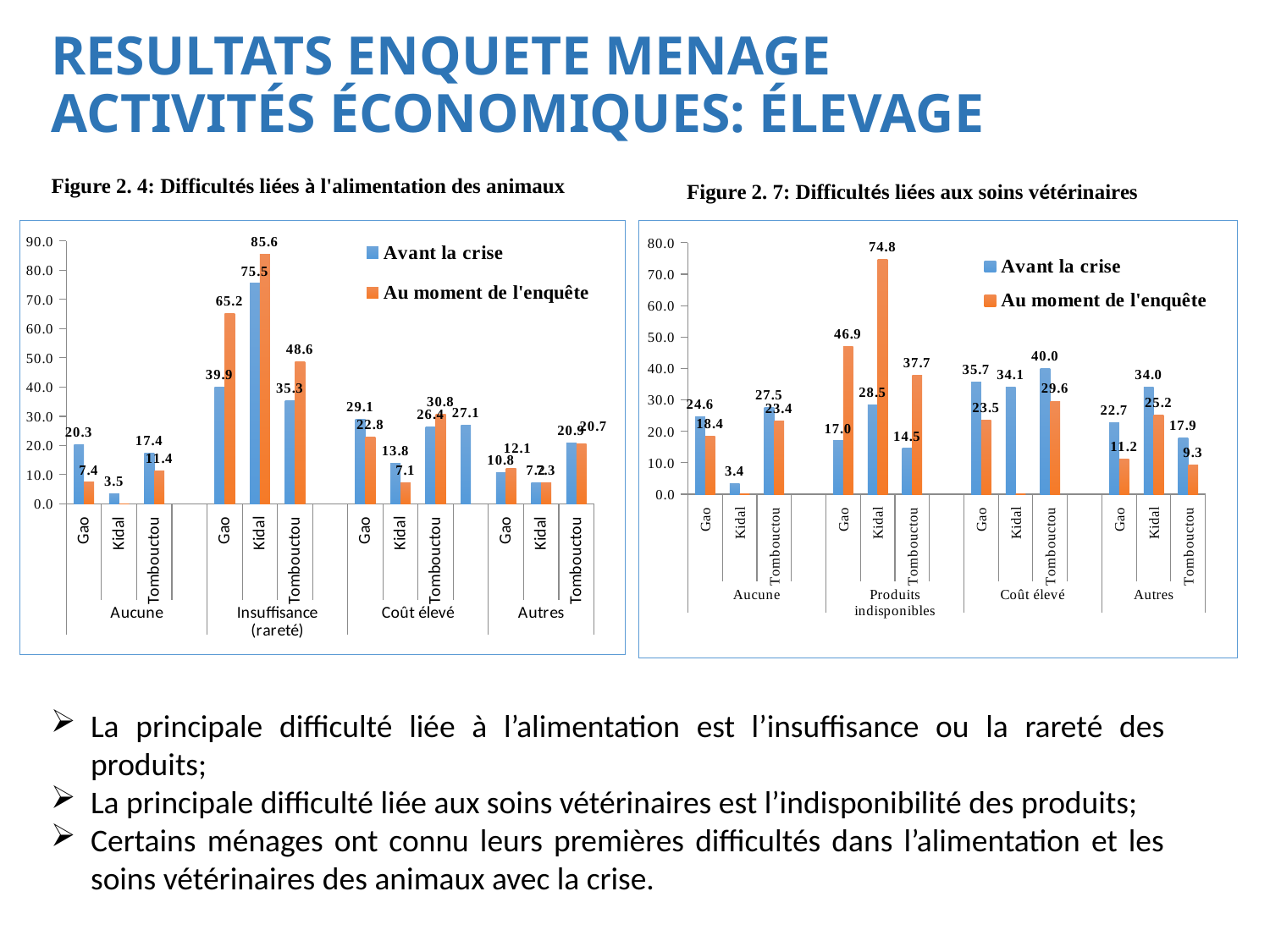
In Figure 2.4 (Difficultés liées à l'alimentation des animaux), what is the difference between the Au moment de l'enquête and Avant la crise values for Gao under Insuffisance (rareté)? 25.3 In Figure 2.4 (Difficultés liées à l'alimentation des animaux), for Kidal under Coût élevé, which series has the larger value: Avant la crise or Au moment de l'enquête? Avant la crise In Figure 2.7 (Difficultés liées aux soins vétérinaires), how many difficulty categories are shown on the x axis? 4 In Figure 2.4 (Difficultés liées à l'alimentation des animaux), how many series does the legend list? 2 In Figure 2.7 (Difficultés liées aux soins vétérinaires), for Gao under Coût élevé, which series has the larger value: Avant la crise or Au moment de l'enquête? Avant la crise In Figure 2.4 (Difficultés liées à l'alimentation des animaux), what is the value for Gao under Aucune for the series Avant la crise? 20.3 In Figure 2.7 (Difficultés liées aux soins vétérinaires), what is the value for Tombouctou under Coût élevé for the series Avant la crise? 40.0 In Figure 2.4 (Difficultés liées à l'alimentation des animaux), which bar is the highest in the whole chart? Kidal, Insuffisance (rareté), Au moment de l'enquête (85.6) What type of chart is Figure 2.7 (Difficultés liées aux soins vétérinaires)? Bar chart In Figure 2.7 (Difficultés liées aux soins vétérinaires), what is the difference between the Au moment de l'enquête and Avant la crise values for Gao under Produits indisponibles? 29.9 In Figure 2.7 (Difficultés liées aux soins vétérinaires), what is the value for Kidal under Produits indisponibles for the series Au moment de l'enquête? 74.8 In Figure 2.4 (Difficultés liées à l'alimentation des animaux), what is the value for Kidal under Insuffisance (rareté) for the series Au moment de l'enquête? 85.6